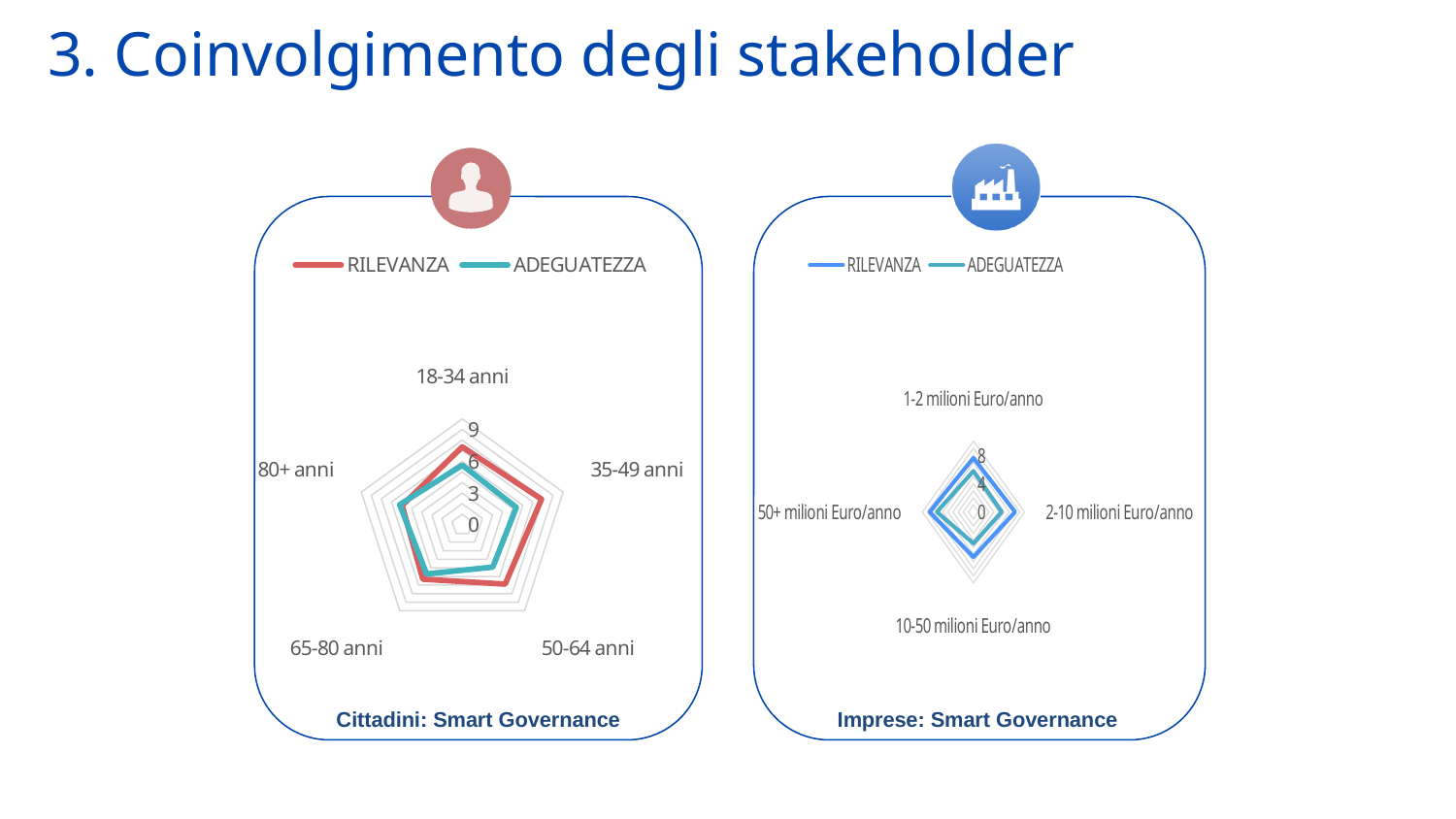
In the 'Imprese: Smart Governance' chart, is the RILEVANZA value for 10-50 milioni Euro/anno greater or less than 4? greater What are the two series listed in the legend of the 'Imprese: Smart Governance' chart? RILEVANZA and ADEGUATEZZA In the 'Cittadini: Smart Governance' chart, which series has the larger value for 35-49 anni, RILEVANZA or ADEGUATEZZA? RILEVANZA How many categories does the 'Imprese: Smart Governance' chart have? 4 How many categories does the 'Cittadini: Smart Governance' chart have? 5 In the 'Imprese: Smart Governance' chart, which series has the larger value for 1-2 milioni Euro/anno, RILEVANZA or ADEGUATEZZA? RILEVANZA What kind of chart is the 'Cittadini: Smart Governance' chart? Radar chart In the 'Cittadini: Smart Governance' chart, is the RILEVANZA value for 50-64 anni greater or less than 6? greater How many series does the legend of the 'Cittadini: Smart Governance' chart list? 2 In the 'Cittadini: Smart Governance' chart, is the ADEGUATEZZA value for 35-49 anni greater or less than 6? less